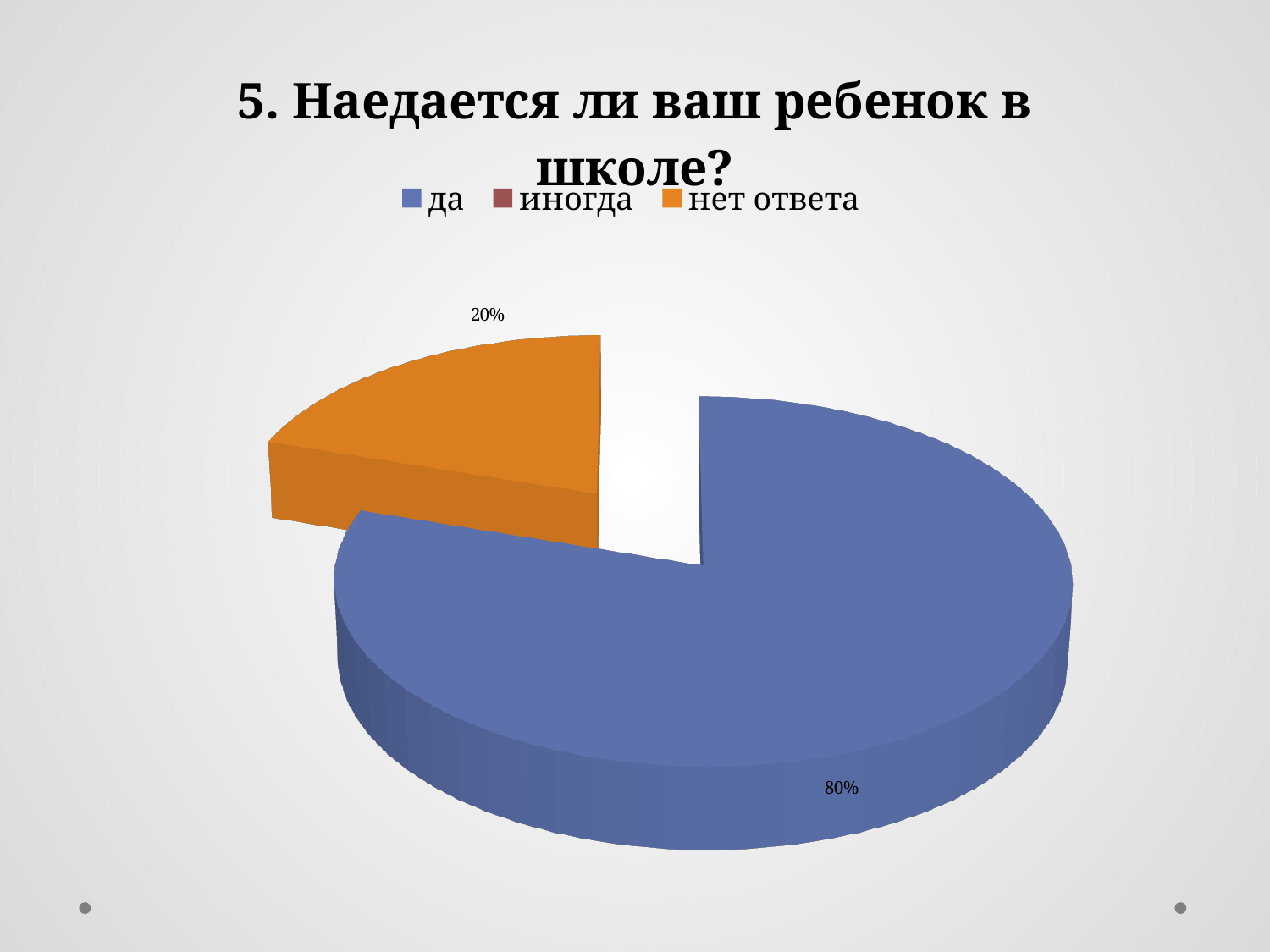
What percentage is shown for the "да" slice? 80% What is the title of the chart? 5. Наедается ли ваш ребенок в школе? What colour is the "нет ответа" slice? orange Which category has the largest slice of the pie? да What kind of chart is shown on the slide? pie chart Which is larger, the "да" slice or the "нет ответа" slice? да What percentage is shown for the "нет ответа" slice? 20% What share of the pie does the "нет ответа" slice represent? 20% Which of the two labelled slices is smaller, "да" or "нет ответа"? нет ответа By how many percentage points does the "да" slice exceed the "нет ответа" slice? 60 How many entries does the legend list? 3 How many slices with data labels are visible in the pie? 2